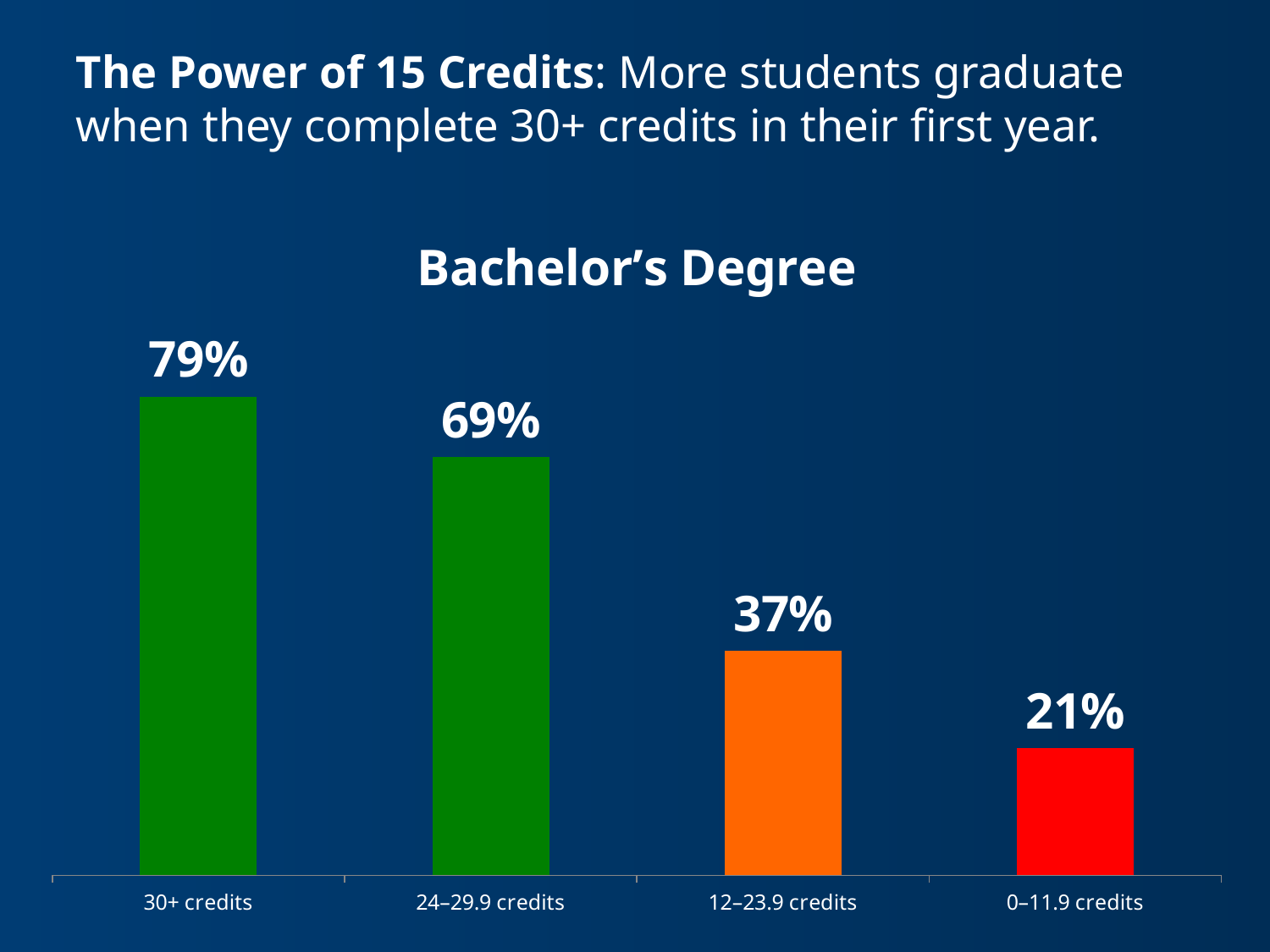
How many categories are shown on the chart? 4 What is the value for 0–11.9 credits? 21% What is the value for 30+ credits? 79% What is the difference between the values for 24–29.9 credits and 12–23.9 credits? 32% Which is larger, the value for 12–23.9 credits or the value for 0–11.9 credits? 12–23.9 credits Which category has the highest value? 30+ credits What kind of chart is shown on the slide? bar chart Which category has the lowest value? 0–11.9 credits What is the title of the chart? Bachelor’s Degree What is the value for 24–29.9 credits? 69% What is the value for 12–23.9 credits? 37% What is the difference between the values for 30+ credits and 0–11.9 credits? 58%